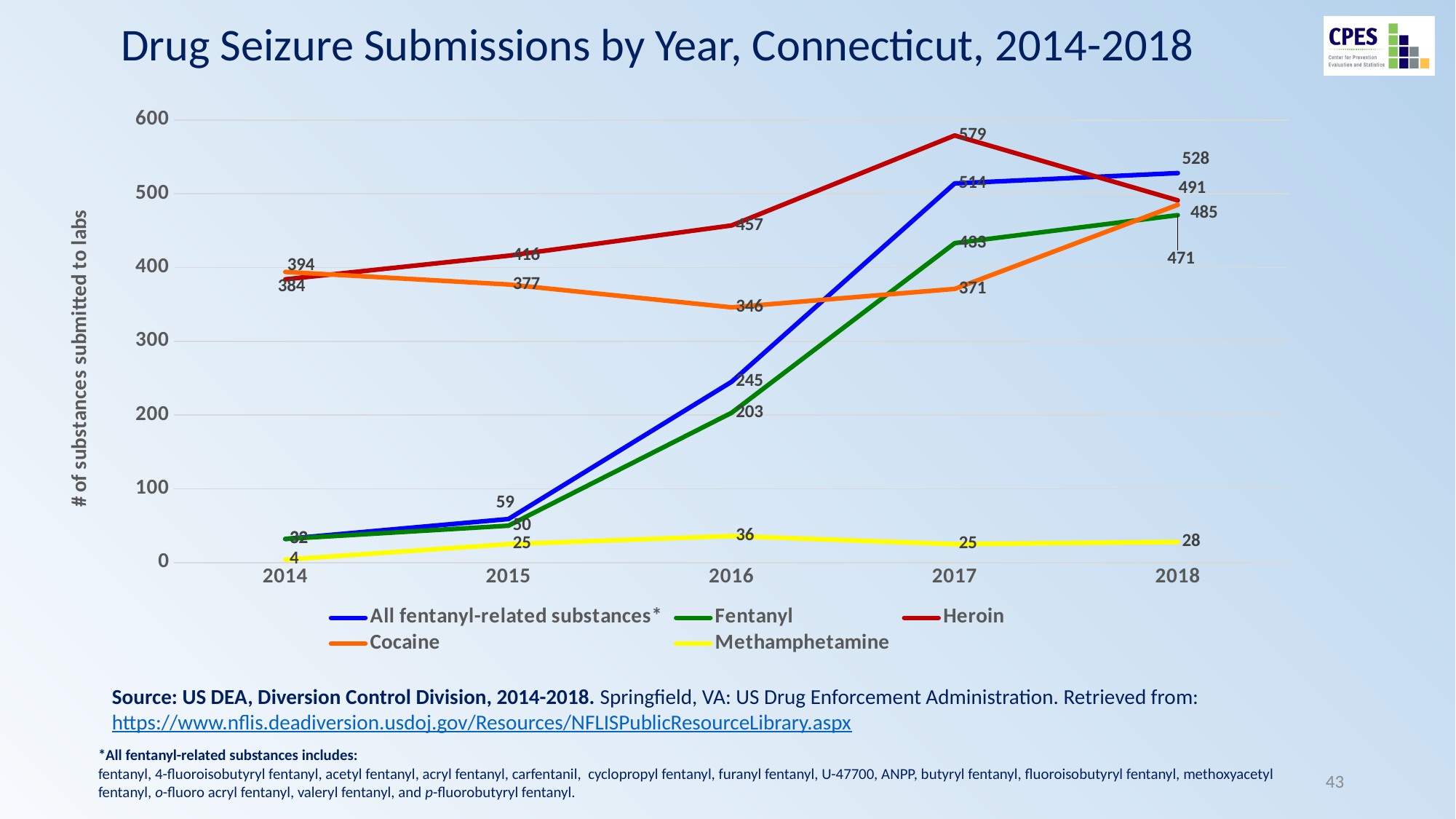
What was the number of Cocaine submissions in 2016? 346 What was the number of Heroin submissions in 2017? 579 How many series does the legend list? 5 In which year were Heroin submissions highest? 2017 What kind of chart is shown on the slide? line chart How many years are plotted along the x axis? 5 In which year were Cocaine submissions lowest? 2016 Do All fentanyl-related substances submissions rise or fall from 2014 to 2018? rise In 2018, which was larger: All fentanyl-related substances or Heroin? All fentanyl-related substances By how much did Heroin submissions fall from 2017 to 2018? 88 What is the label on the y axis? # of substances submitted to labs What was the number of Methamphetamine submissions in 2014? 4